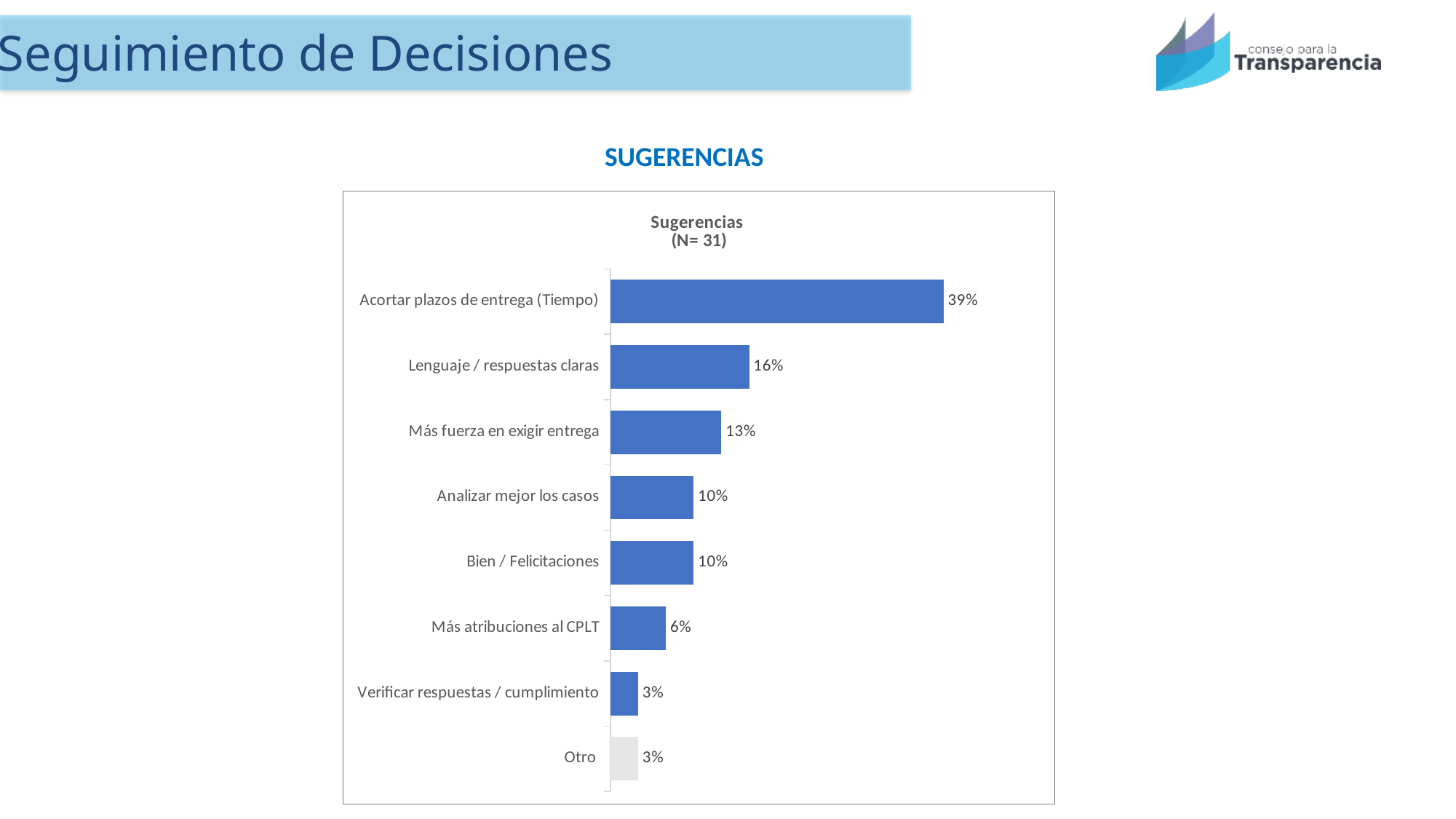
Which is larger, "Lenguaje / respuestas claras" or "Más fuerza en exigir entrega"? Lenguaje / respuestas claras What is the difference between "Más fuerza en exigir entrega" and "Analizar mejor los casos"? 3% Which category's bar is shown in grey rather than blue? Otro What is the difference between "Acortar plazos de entrega (Tiempo)" and "Lenguaje / respuestas claras"? 23% What is the value for "Lenguaje / respuestas claras"? 16% How many categories are shown in the chart? 8 Which category has the highest value? Acortar plazos de entrega (Tiempo) What is the value for "Más fuerza en exigir entrega"? 13% What kind of chart is shown? Bar chart What is the sample size (N) stated in the chart title? 31 What is the value for "Acortar plazos de entrega (Tiempo)"? 39% What is the value for "Más atribuciones al CPLT"? 6%